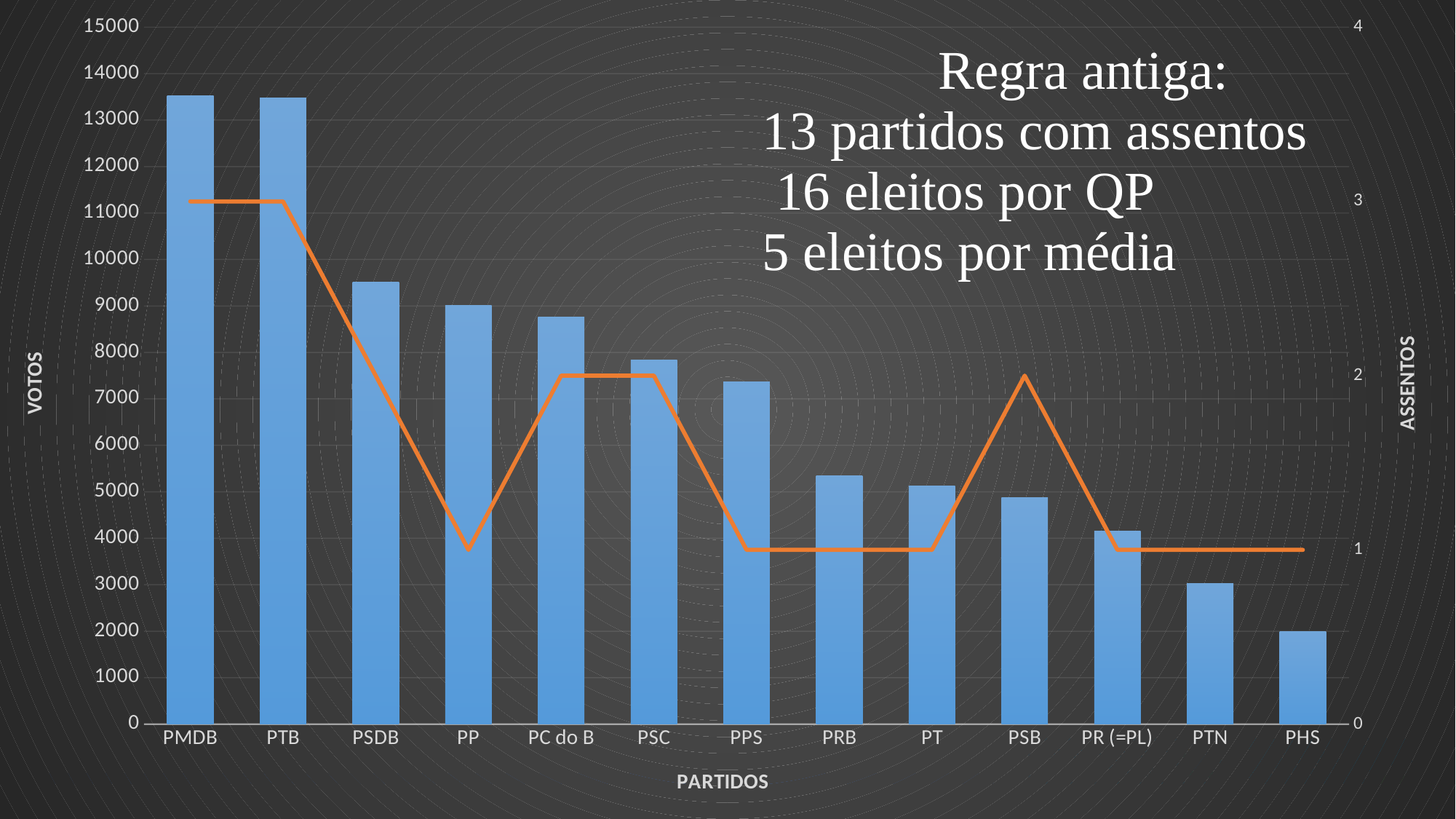
What is the title of the x axis of the chart? PARTIDOS Do the VOTOS bars generally rise or fall from left to right along the x axis? fall How many ASSENTOS does the line show for PMDB? 3 Is the VOTOS value for PR (=PL) greater or less than 5000? less Which party has more VOTOS, PSC or PT? PSC Is the VOTOS value for PPS greater or less than 8000? less How many parties are shown on the x axis of the chart? 13 Is the VOTOS value for PSDB greater or less than 9000? greater What kind of chart is used to show the VOTOS values? bar chart How many ASSENTOS does the line show for PSB? 2 Which party has the lowest bar for VOTOS? PHS